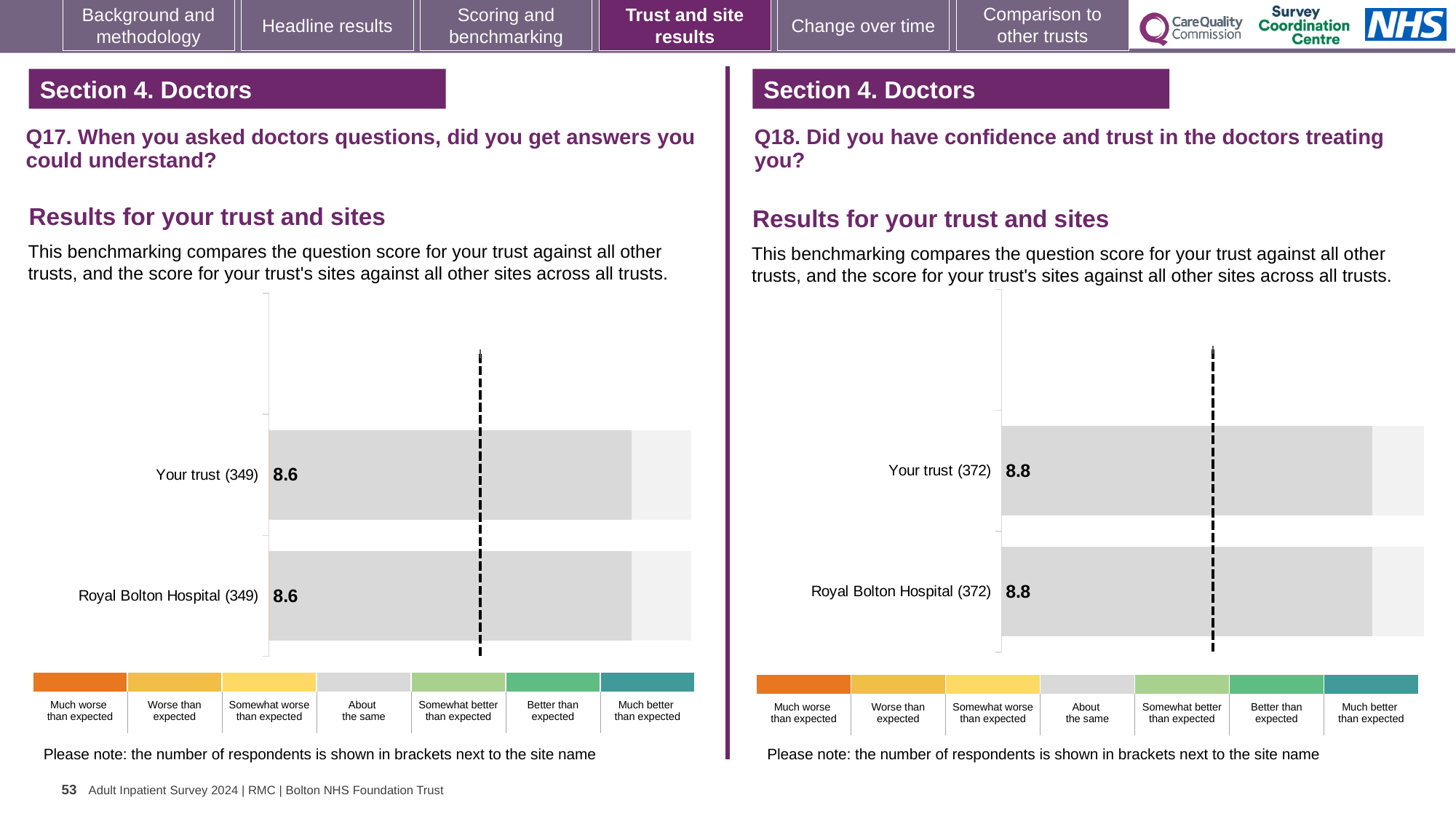
What kind of chart is the Q18 chart (right)? Bar chart On the Q18 chart (right), what is the score for Royal Bolton Hospital? 8.8 On the Q18 chart (right), what is the difference between the score for Your trust and the score for Royal Bolton Hospital? 0 How many bars are plotted on the Q18 chart (right)? 2 On the Q18 chart (right), what is the score for Your trust? 8.8 How many bars are plotted on the Q17 chart (left)? 2 On the Q17 chart (left), what is the score for Your trust? 8.6 On the Q18 chart (right), how many respondents are shown in brackets next to Royal Bolton Hospital? 372 On the Q17 chart (left), what is the score for Royal Bolton Hospital? 8.6 On the Q17 chart (left), what is the difference between the score for Your trust and the score for Royal Bolton Hospital? 0 Is the score for Your trust on the Q18 chart (right) larger or smaller than the score for Your trust on the Q17 chart (left)? Larger On the Q17 chart (left), how many respondents are shown in brackets next to Your trust? 349